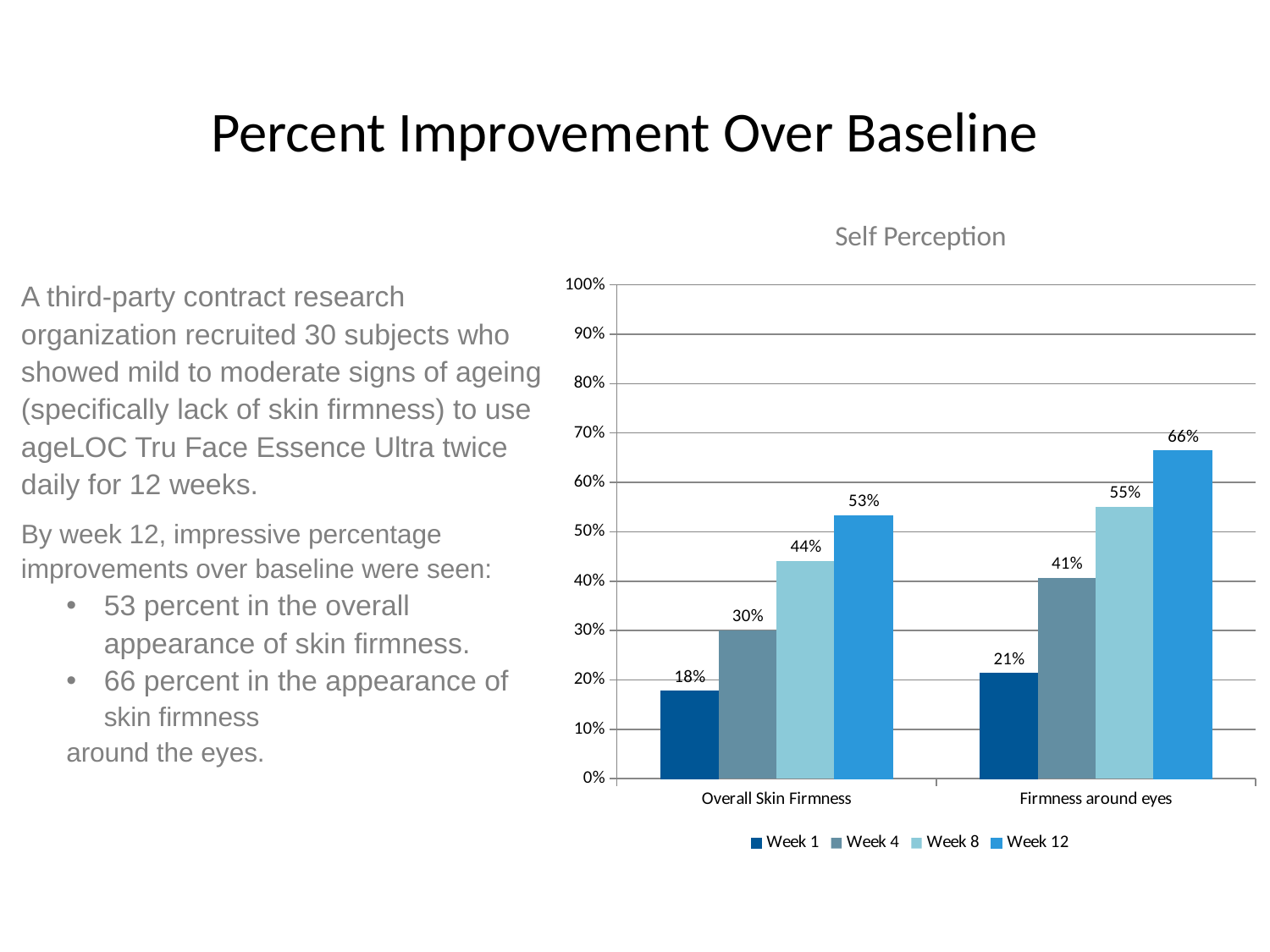
What is the difference between the Week 12 values for Firmness around eyes and Overall Skin Firmness? 13% What is the Week 8 value for Overall Skin Firmness? 44% How many categories are shown on the x axis? 2 Which is larger: the Week 8 value for Firmness around eyes or the Week 12 value for Overall Skin Firmness? Week 8 value for Firmness around eyes What is the Week 12 value for Overall Skin Firmness? 53% What is the Week 1 value for Firmness around eyes? 21% Which series has the highest value for Firmness around eyes? Week 12 Which series has the lowest value for Overall Skin Firmness? Week 1 What kind of chart is shown? Bar chart How many series does the legend list? 4 What is the Week 4 value for Firmness around eyes? 41% What is the title of the chart? Self Perception